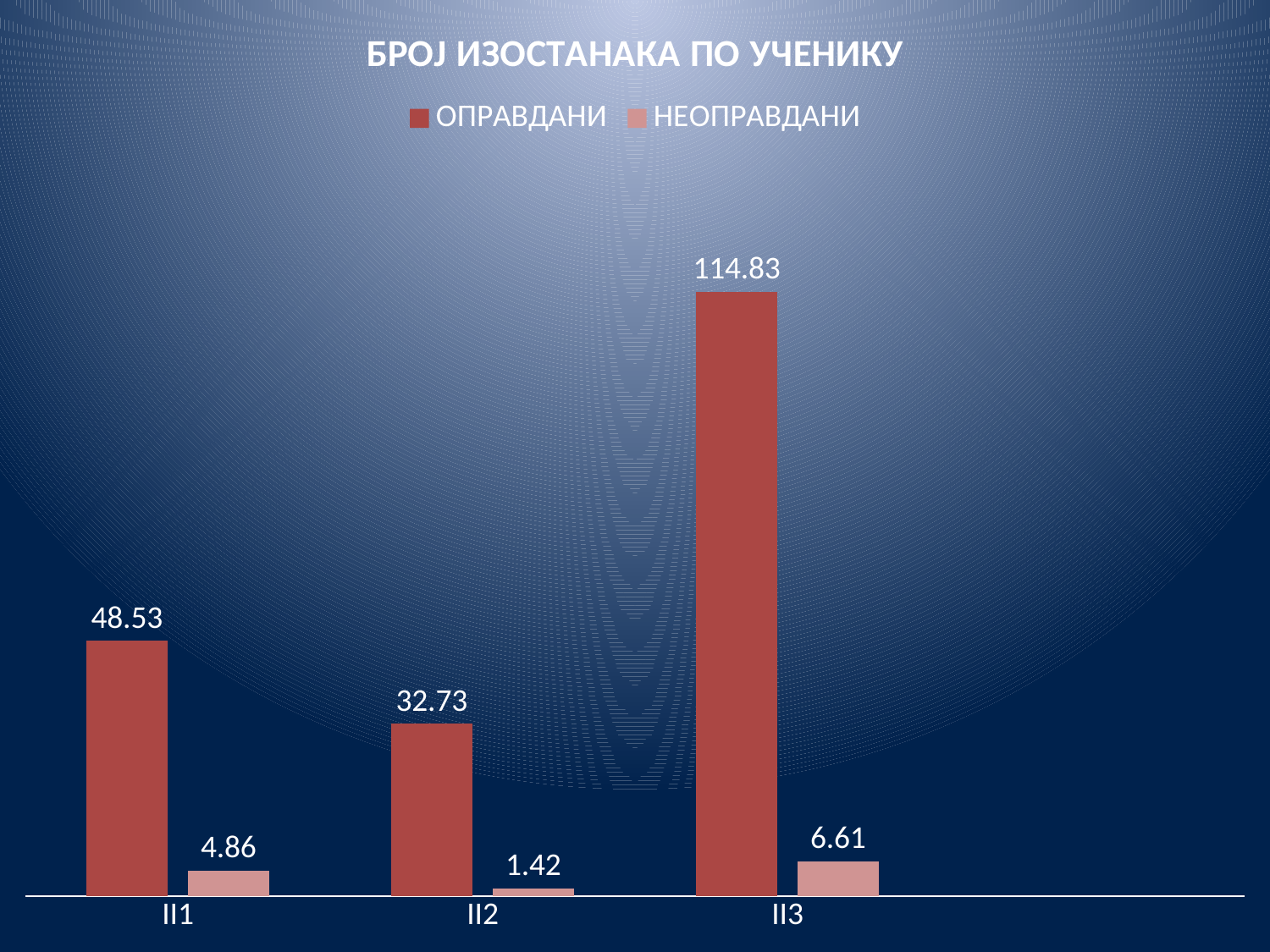
What is the title of the chart? БРОЈ ИЗОСТАНАКА ПО УЧЕНИКУ What is the НЕОПРАВДАНИ value for II1? 4.86 Which category has the highest ОПРАВДАНИ value? II3 What is the difference between the ОПРАВДАНИ values for II3 and II1? 66.3 Which category has the lowest НЕОПРАВДАНИ value? II2 What is the ОПРАВДАНИ value for II3? 114.83 How many categories are shown on the x axis? 3 Which is larger, the НЕОПРАВДАНИ value for II3 or for II1? II3 How many series does the legend list? 2 What is the НЕОПРАВДАНИ value for II2? 1.42 What is the ОПРАВДАНИ value for II2? 32.73 What kind of chart is shown on the slide? Bar chart